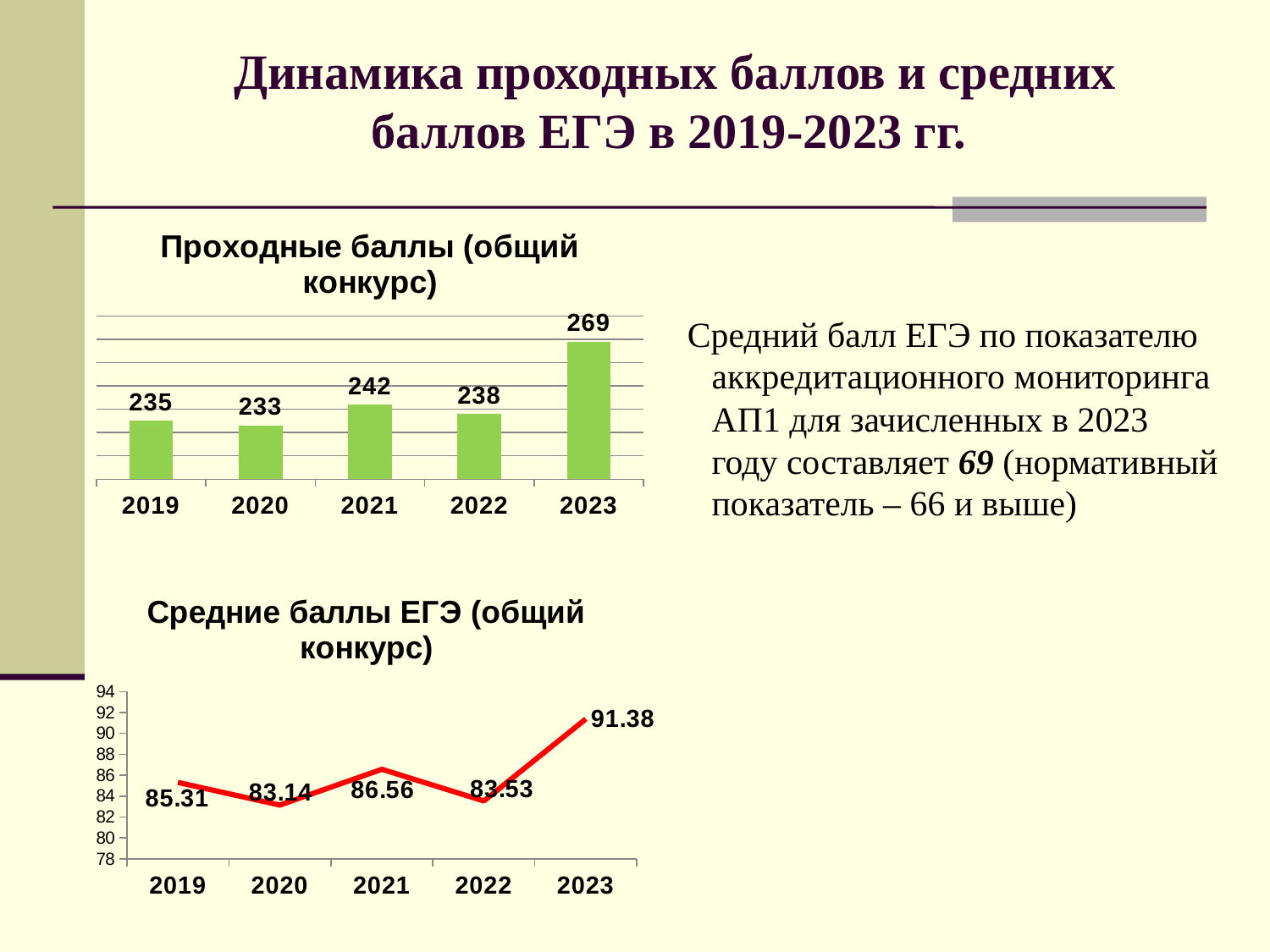
What kind of chart is 'Средние баллы ЕГЭ (общий конкурс)'? line chart What kind of chart is 'Проходные баллы (общий конкурс)'? bar chart In the chart 'Средние баллы ЕГЭ (общий конкурс)', what is the value for 2020? 83.14 In the chart 'Средние баллы ЕГЭ (общий конкурс)', is the value for 2023 greater or less than 90? greater In the chart 'Проходные баллы (общий конкурс)', which is larger: the value for 2019 or the value for 2020? 2019 In the chart 'Проходные баллы (общий конкурс)', which year has the lowest value? 2020 In the chart 'Проходные баллы (общий конкурс)', what is the value for 2021? 242 In the chart 'Средние баллы ЕГЭ (общий конкурс)', which year has the lowest value? 2020 In the chart 'Проходные баллы (общий конкурс)', how many years are shown on the x axis? 5 In the chart 'Проходные баллы (общий конкурс)', which year has the highest value? 2023 In the chart 'Проходные баллы (общий конкурс)', what is the difference between the values for 2023 and 2022? 31 In the chart 'Средние баллы ЕГЭ (общий конкурс)', what is the value for 2023? 91.38